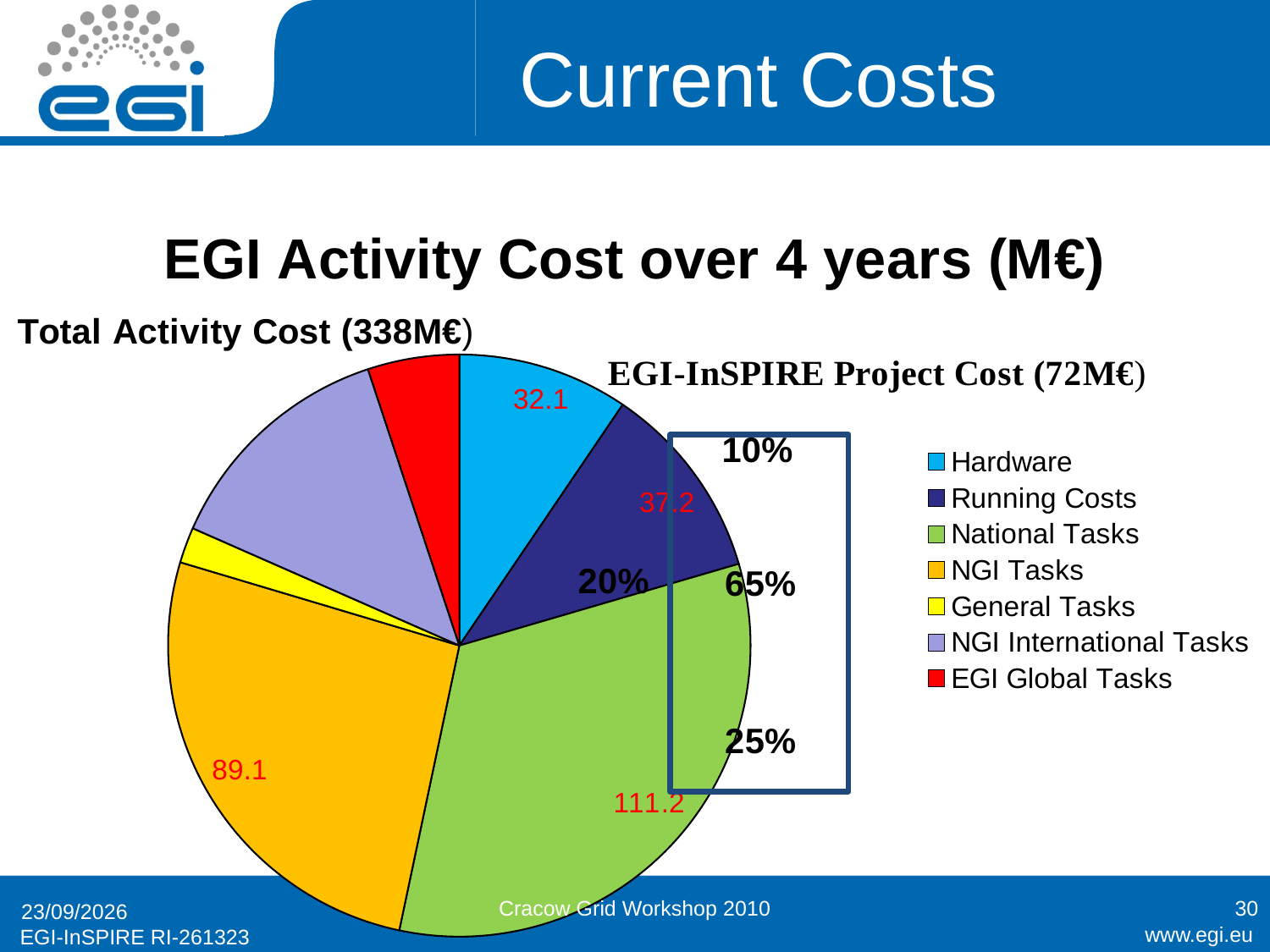
Which category has the smallest slice in the pie chart? General Tasks What is the title of the chart? EGI Activity Cost over 4 years (M€) Which is larger, the value for Hardware or the value for Running Costs? Running Costs What is the value for Running Costs in the pie chart? 37.2 What is the value for National Tasks in the pie chart? 111.2 What is the value for NGI Tasks in the pie chart? 89.1 What kind of chart is shown on the slide? Pie chart What is the difference between the values for Running Costs and Hardware? 5.1 How many categories does the pie chart have? 7 What is the difference between the values for National Tasks and NGI Tasks? 22.1 What is the value for Hardware in the pie chart? 32.1 Which category has the largest slice in the pie chart? National Tasks